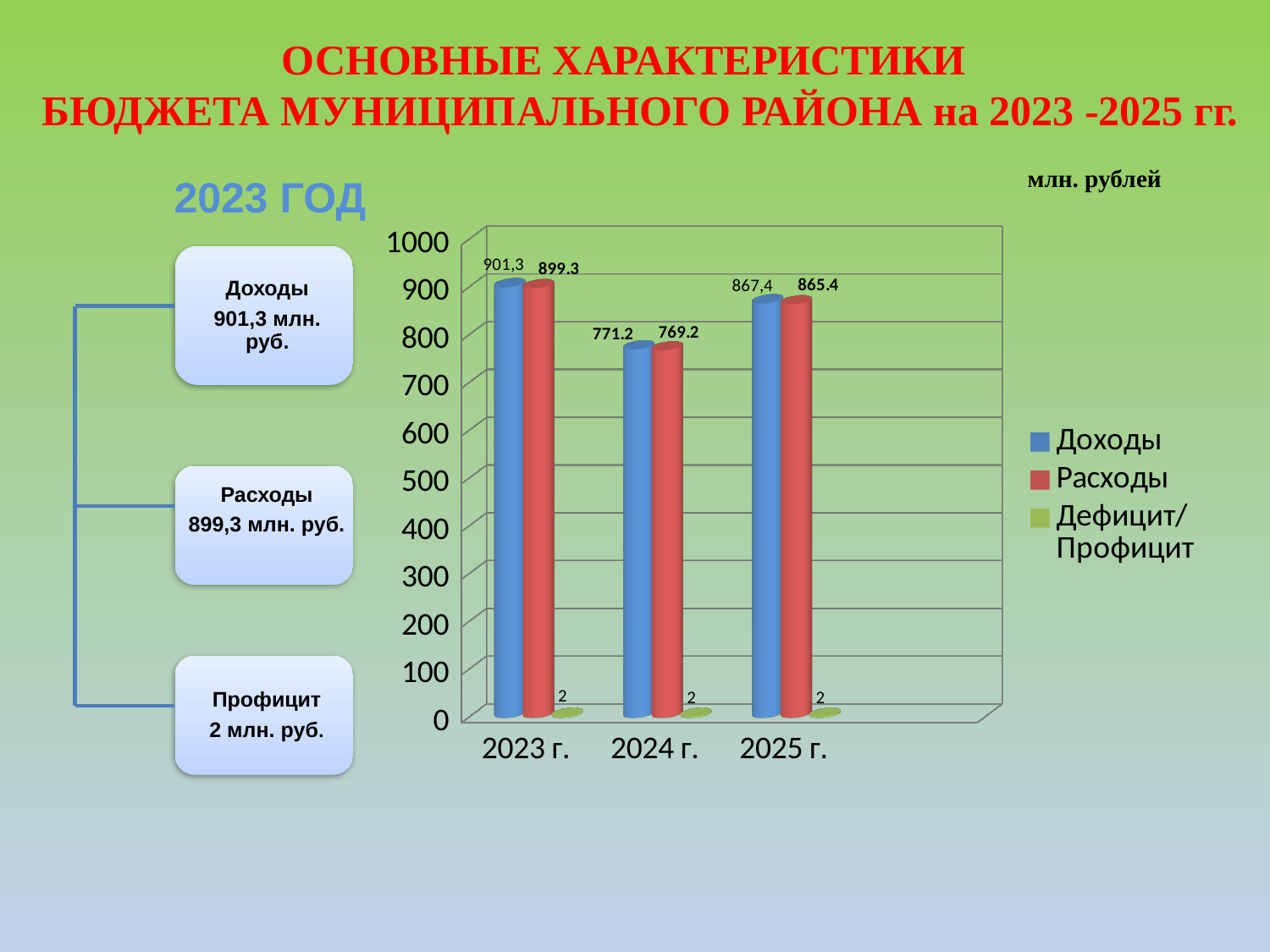
What is the value of Расходы for 2024 г.? 769.2 Is the value of Расходы for 2024 г. greater or less than 800? less What is the value of Доходы for 2025 г.? 867,4 How many years are shown on the x axis of the chart? 3 In which year is Доходы the lowest? 2024 г. In which year is Расходы the highest? 2023 г. What kind of chart is shown on the slide? bar chart Which is larger in 2025 г., Доходы or Расходы? Доходы What is the value of Дефицит/Профицит for 2024 г.? 2 How many series does the chart legend list? 3 What is the value of Доходы for 2023 г.? 901,3 What is the difference between Доходы and Расходы in 2024 г.? 2